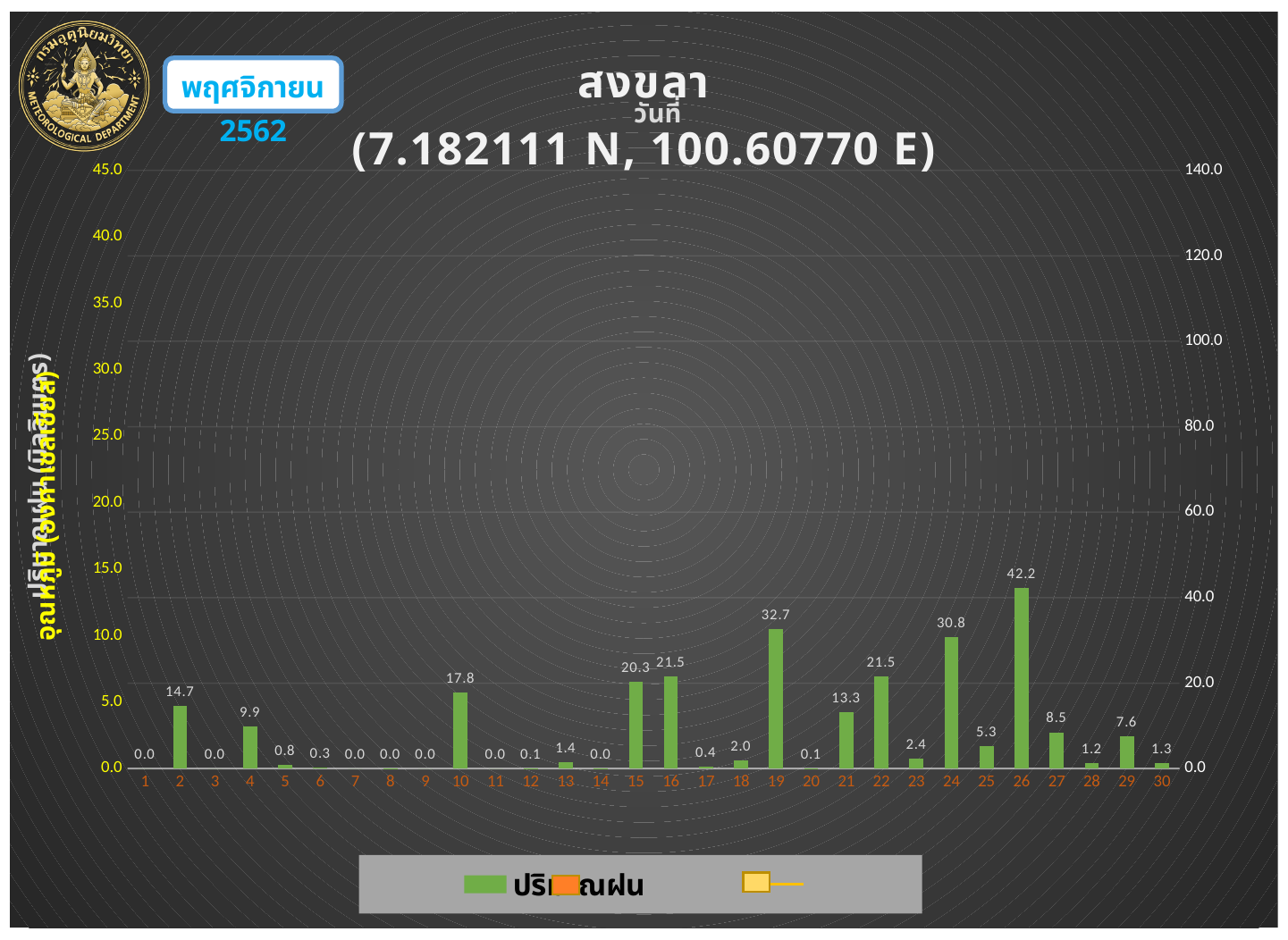
What kind of chart is shown on the slide? bar chart What is the difference between the rainfall values for day 26 and day 19? 9.5 What is the rainfall value shown for day 10? 17.8 Which day has the larger rainfall value, day 19 or day 24? 19 Which day has the highest rainfall value? 26 What is the rainfall value shown for day 2? 14.7 Is the value for day 26 greater or less than 40.0 on the right-hand axis? greater What is the rainfall value shown for day 26? 42.2 What is the rainfall value shown for day 19? 32.7 What is the difference between the rainfall values for day 24 and day 21? 17.5 Which day has the larger rainfall value, day 4 or day 27? 4 How many days are shown on the x axis? 30